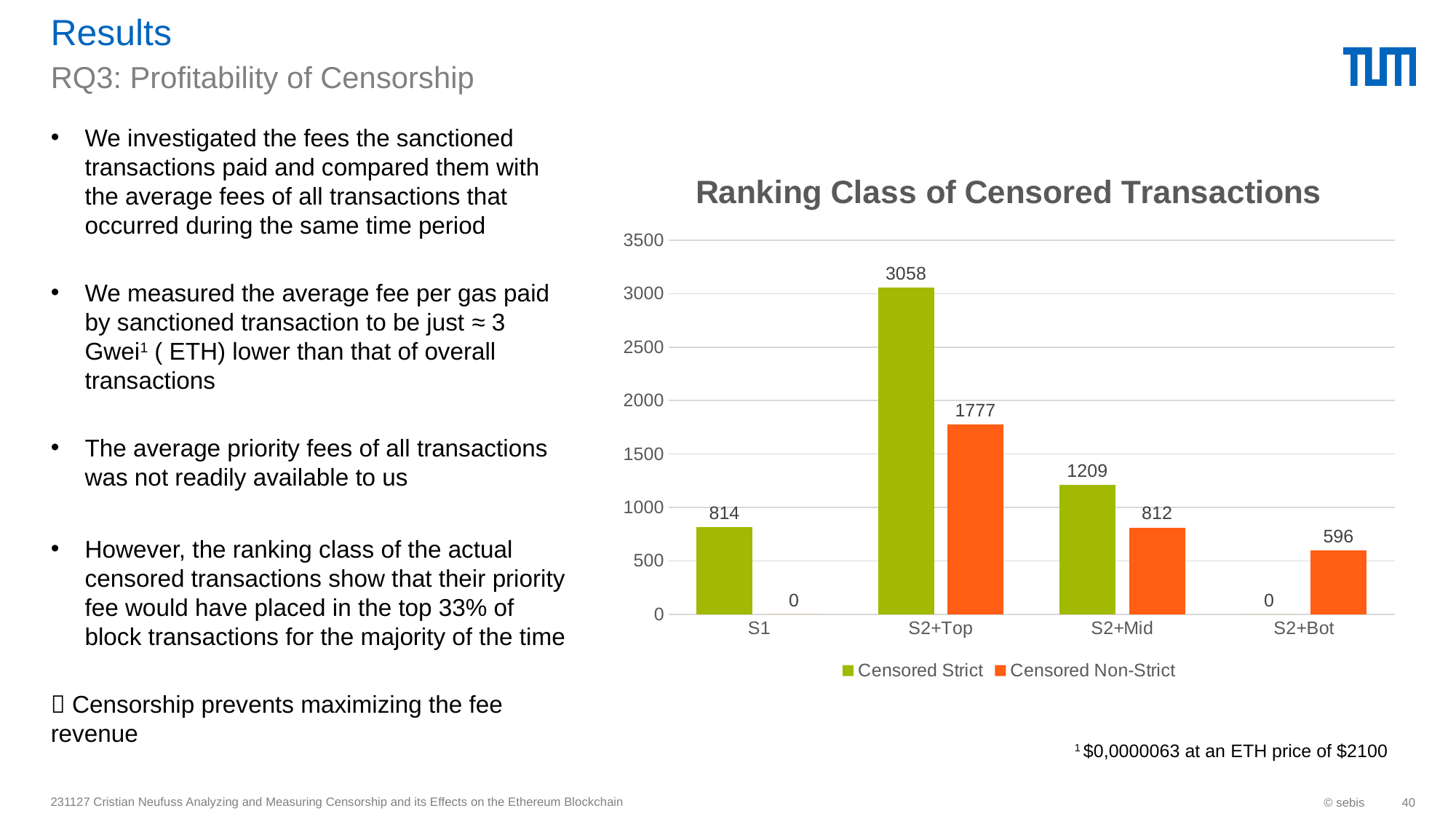
Which is larger for S2+Mid: Censored Strict or Censored Non-Strict? Censored Strict What is the Censored Non-Strict value for S2+Mid? 812 What is the difference between the Censored Strict and Censored Non-Strict values for S2+Top? 1281 What is the title of the chart? Ranking Class of Censored Transactions What kind of chart is shown on the slide? Bar chart What is the Censored Non-Strict value for S2+Bot? 596 How many categories are shown on the x axis? 4 Which category has the highest Censored Strict value? S2+Top What is the Censored Strict value for S1? 814 What is the Censored Strict value for S2+Top? 3058 How many series does the legend list? 2 Which category has the lowest Censored Non-Strict value? S1